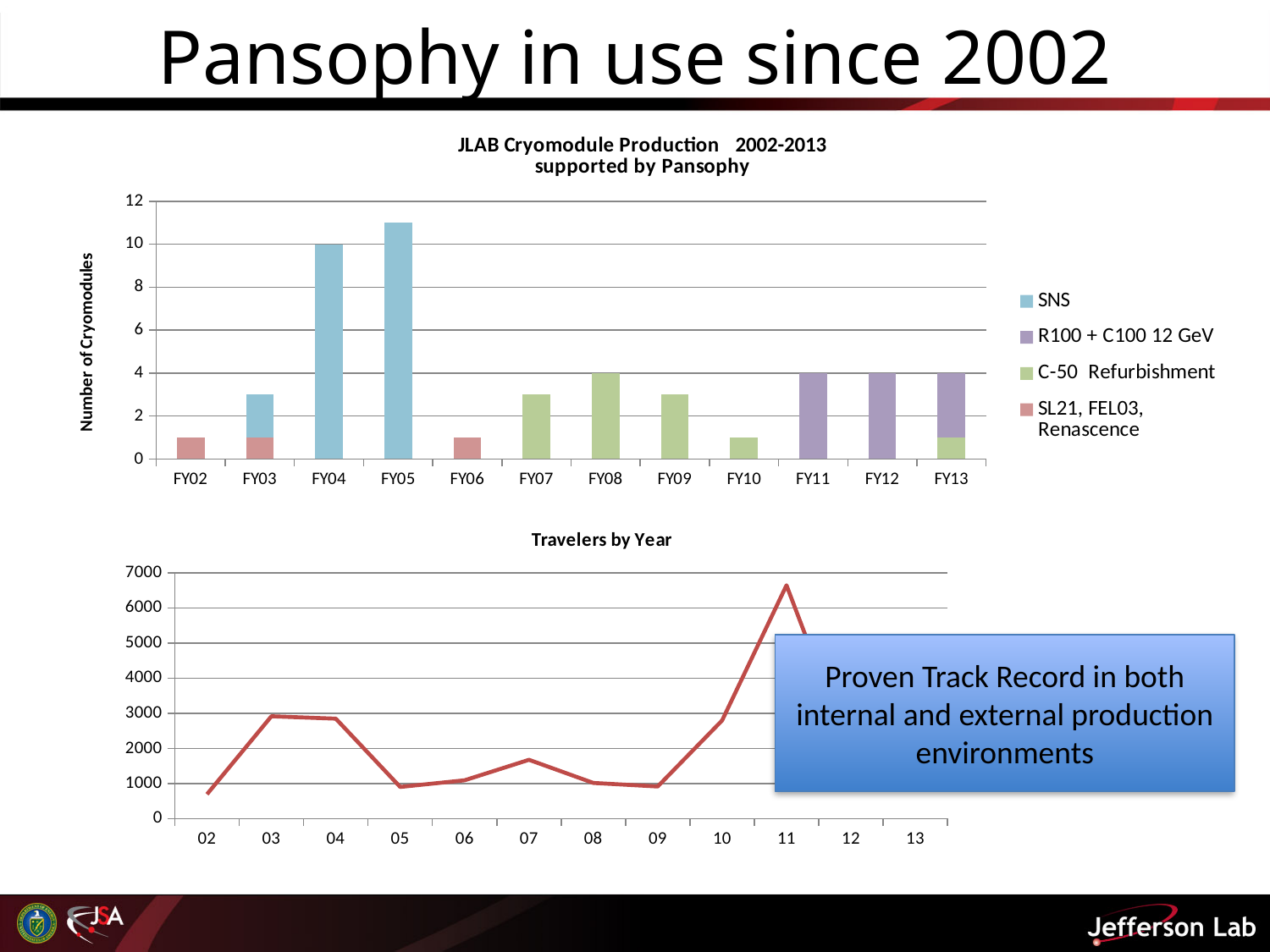
In the 'JLAB Cryomodule Production 2002-2013 supported by Pansophy' chart, is the value for FY05 greater or less than 10? greater In the 'Travelers by Year' chart, which year has the highest value? 11 In the 'JLAB Cryomodule Production 2002-2013 supported by Pansophy' chart, which is larger, the bar for FY08 or the bar for FY10? FY08 In the 'JLAB Cryomodule Production 2002-2013 supported by Pansophy' chart, what kind of chart is shown? Stacked bar chart In the 'JLAB Cryomodule Production 2002-2013 supported by Pansophy' chart, how many fiscal years are shown on the x axis? 12 In the 'JLAB Cryomodule Production 2002-2013 supported by Pansophy' chart, which series is shown in FY11 and FY12? R100 + C100 12 GeV In the 'Travelers by Year' chart, what kind of chart is shown? Line chart In the 'JLAB Cryomodule Production 2002-2013 supported by Pansophy' chart, what is the total height of the FY13 bar? 4 In the 'JLAB Cryomodule Production 2002-2013 supported by Pansophy' chart, how many SNS cryomodules were produced in FY04? 10 In the 'JLAB Cryomodule Production 2002-2013 supported by Pansophy' chart, which fiscal year has the tallest bar? FY05 In the 'Travelers by Year' chart, is the value for year 11 greater or less than 6000? greater In the 'JLAB Cryomodule Production 2002-2013 supported by Pansophy' chart, how many series does the legend list? 4